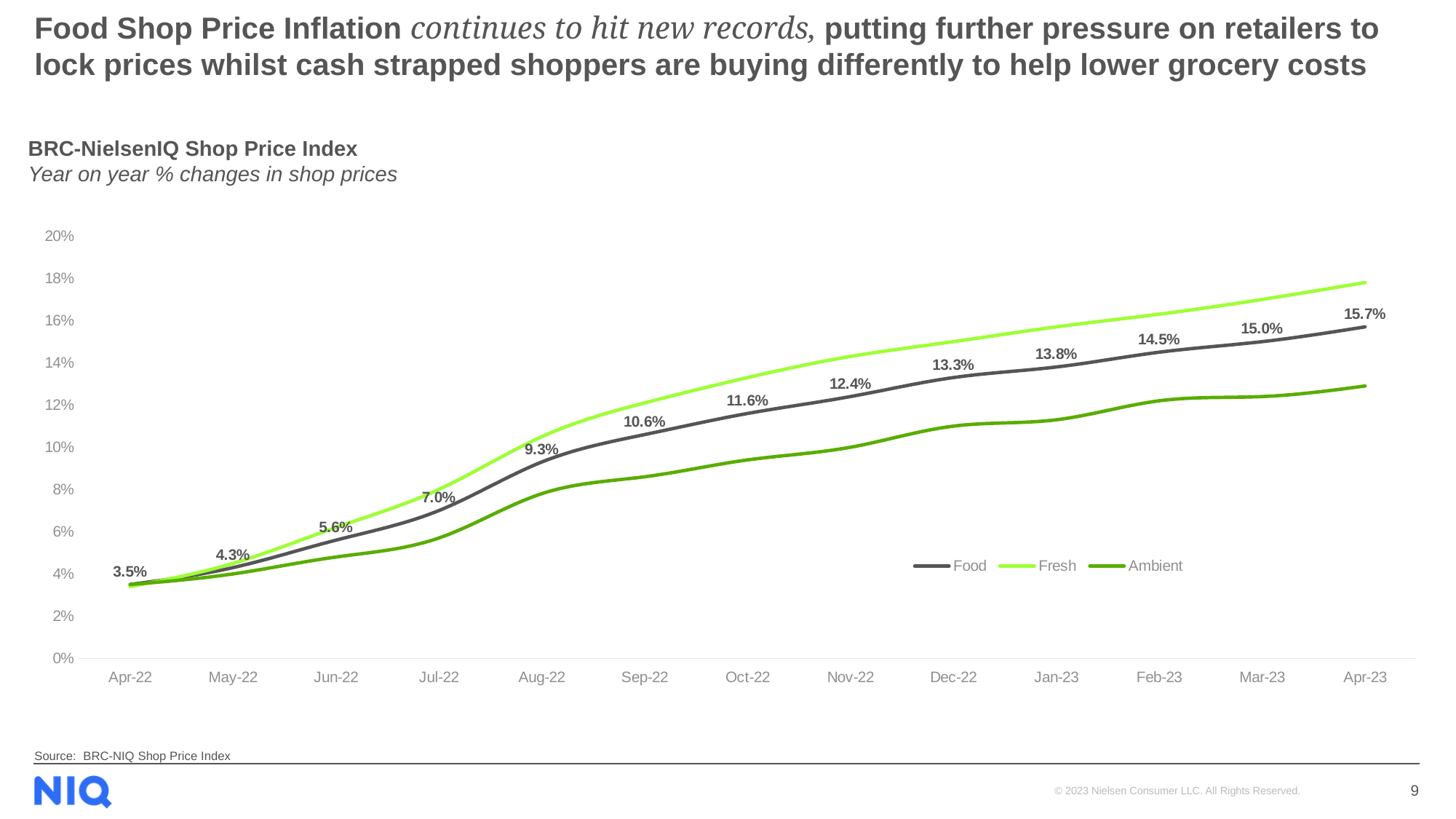
How many months are shown on the x axis? 13 In which month is the Food series at its lowest? Apr-22 What is the difference between the Food values for Dec-22 and Nov-22? 0.9 percentage points By how many percentage points did the Food value rise from Apr-22 to Apr-23? 12.2 percentage points In which month is the Food series at its highest? Apr-23 In Apr-23, which series is higher, Fresh or Ambient? Fresh Is the Ambient value for Apr-23 greater or less than 14%? less Is the Fresh value for Apr-23 greater or less than 16%? greater What is the Food value for Aug-22? 9.3% What is the Food value for Jul-22? 7.0% How many series does the legend list? 3 What is the Food value for Apr-23? 15.7%